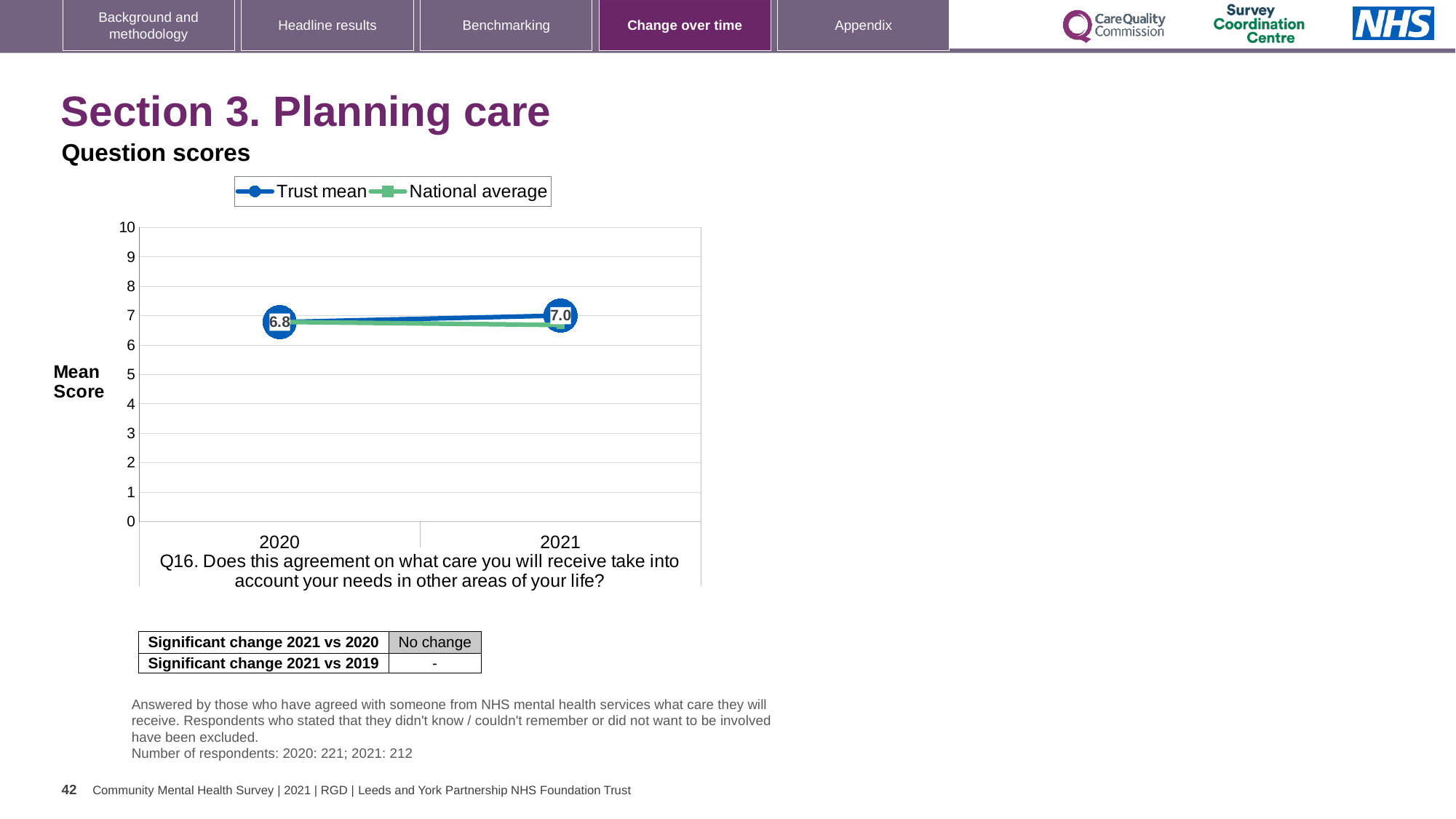
How many years are plotted on the x axis? 2 Is the National average value for 2021 greater or less than 5? greater Does the Trust mean rise or fall from 2020 to 2021? rise Is the National average value for 2020 greater or less than 8? less How many series does the legend list? 2 What kind of chart is shown on the slide? line chart What is the label on the y axis of the chart? Mean Score What is the Trust mean score for 2020? 6.8 What are the two series named in the legend? Trust mean and National average By how much did the Trust mean change from 2020 to 2021? 0.2 What is the Trust mean score for 2021? 7.0 Which year has the higher Trust mean, 2020 or 2021? 2021